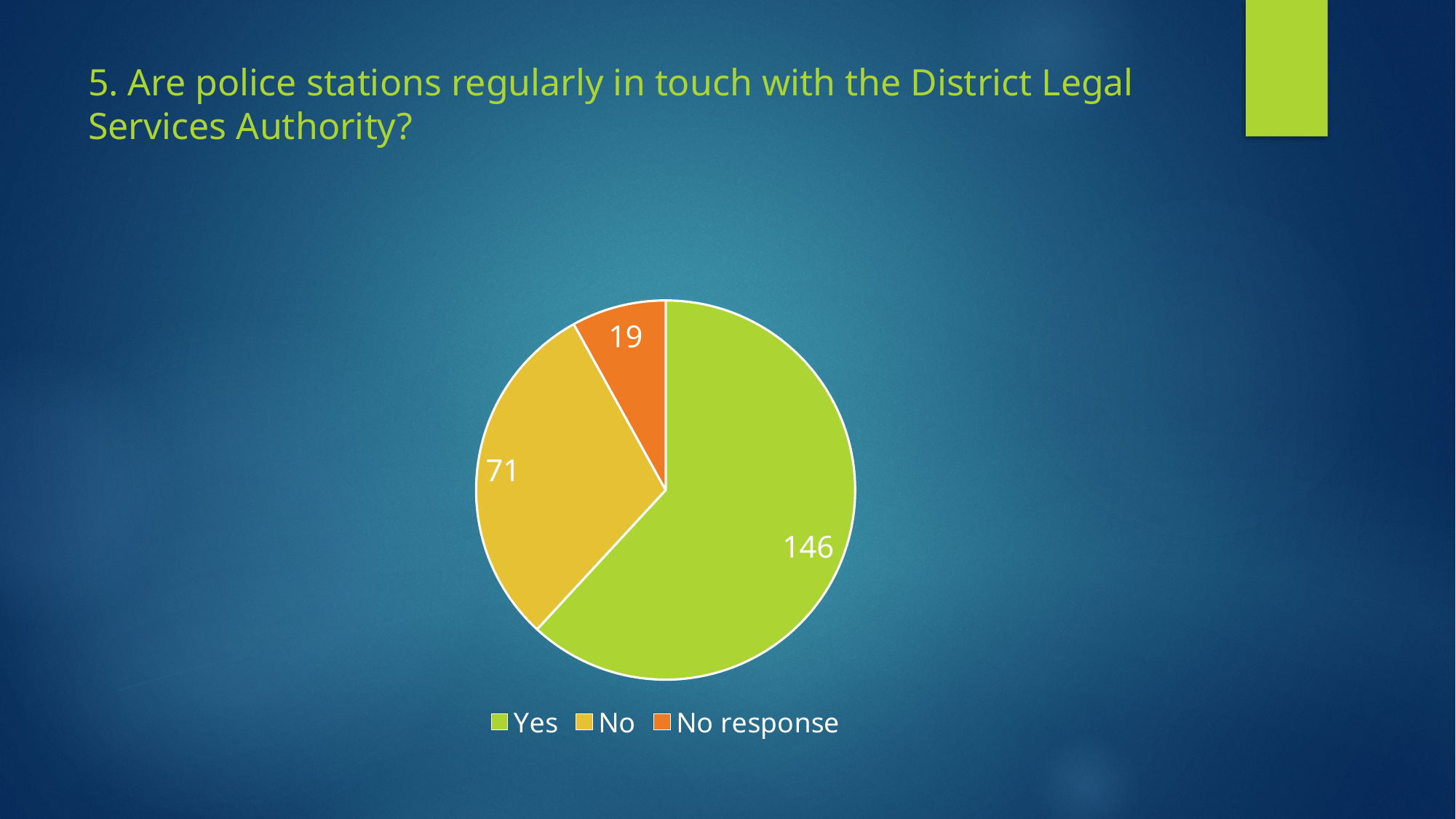
Which category has the largest slice of the pie? Yes Which category has the smallest slice of the pie? No response What value is shown for the No response slice? 19 What value is shown for the Yes slice? 146 Which is larger, the No slice or the No response slice? No What value is shown for the No slice? 71 What type of chart is shown on the slide? Pie chart What is the difference between the No value and the No response value? 52 How many categories does the pie chart show? 3 What is the total of all the slices in the pie chart? 236 What is the difference between the Yes value and the No value? 75 Which colour represents the No response category in the legend? Orange